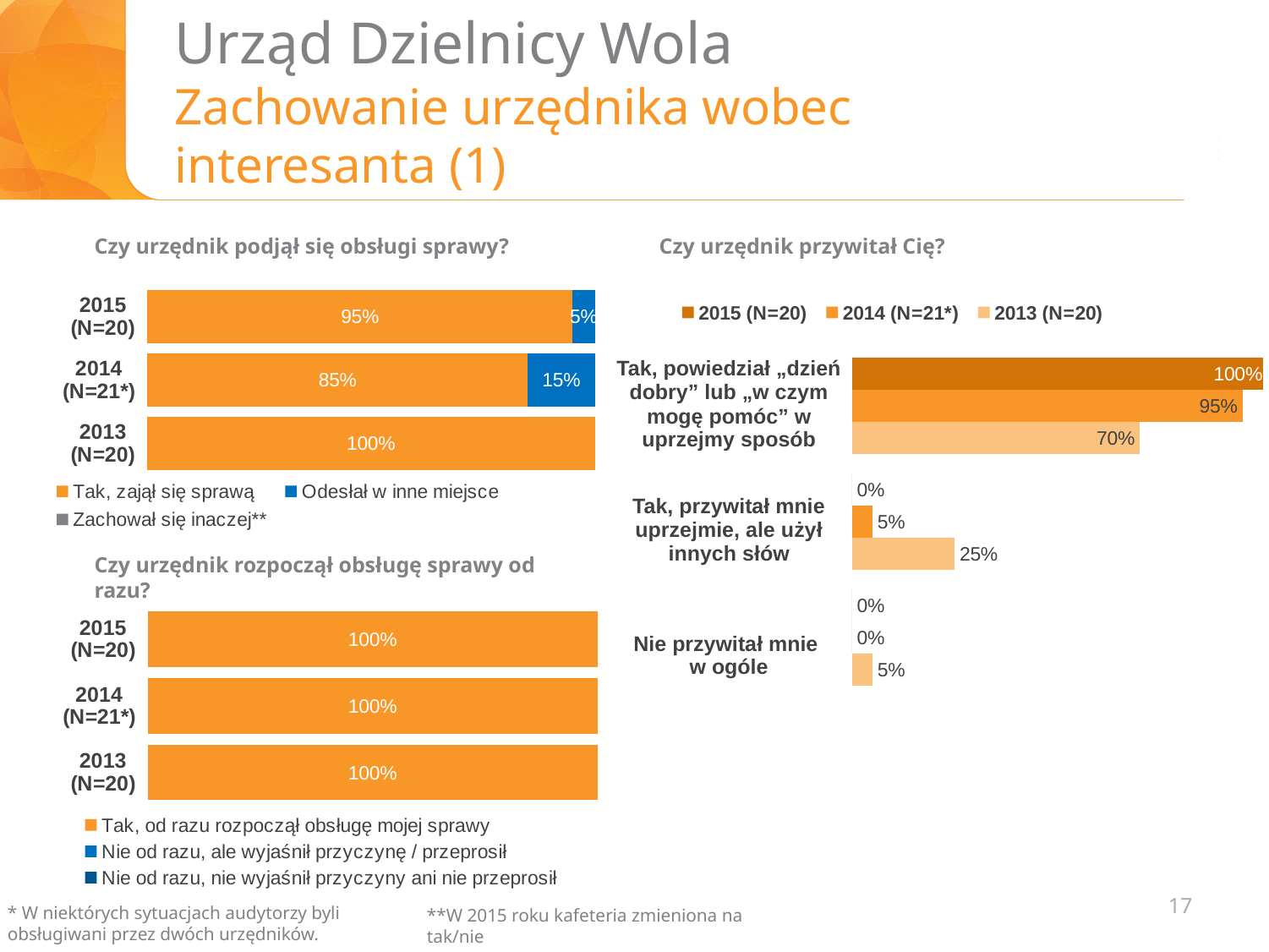
In the chart "Czy urzędnik podjął się obsługi sprawy?", what percentage for 2015 (N=20) is "Tak, zajął się sprawą"? 95% In the chart "Czy urzędnik przywitał Cię?", what is the 2014 (N=21*) value for "Tak, przywitał mnie uprzejmie, ale użył innych słów"? 5% In the chart "Czy urzędnik przywitał Cię?", what is the difference between the 2015 and 2013 values for "Tak, powiedział „dzień dobry” lub „w czym mogę pomóc” w uprzejmy sposób"? 30% In the chart "Czy urzędnik podjął się obsługi sprawy?", how many series does the legend list? 3 In the chart "Czy urzędnik rozpoczął obsługę sprawy od razu?", what percentage for 2014 (N=21*) is "Tak, od razu rozpoczął obsługę mojej sprawy"? 100% In the chart "Czy urzędnik rozpoczął obsługę sprawy od razu?", how many years are shown? 3 In the chart "Czy urzędnik przywitał Cię?", what is the 2013 (N=20) value for "Tak, powiedział „dzień dobry” lub „w czym mogę pomóc” w uprzejmy sposób"? 70% In the chart "Czy urzędnik podjął się obsługi sprawy?", what percentage for 2014 (N=21*) is "Odesłał w inne miejsce"? 15% In the chart "Czy urzędnik przywitał Cię?", which year has the highest value for "Tak, powiedział „dzień dobry” lub „w czym mogę pomóc” w uprzejmy sposób"? 2015 (N=20) In the chart "Czy urzędnik podjął się obsługi sprawy?", what is the difference between the "Tak, zajął się sprawą" values for 2015 and 2014? 10% What kind of chart is "Czy urzędnik przywitał Cię?"? Bar chart In the chart "Czy urzędnik podjął się obsługi sprawy?", which year has the highest share of "Tak, zajął się sprawą"? 2013 (N=20)